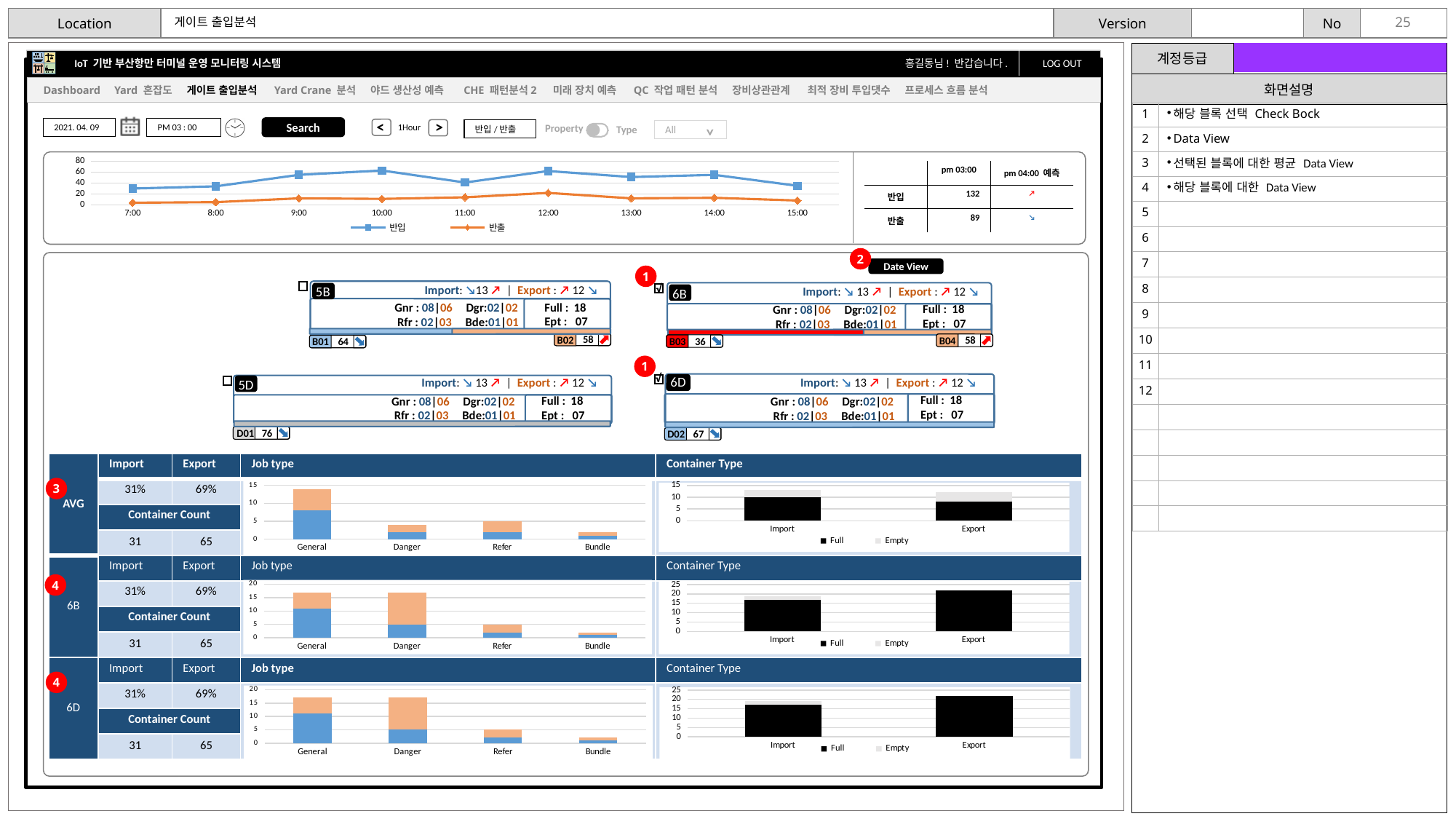
In the AVG Job type chart, is the total bar for General greater or less than 10? greater In the top line chart, which series has the larger value at 12:00, 반입 or 반출? 반입 How many series does the legend of the top line chart list? 2 In the AVG Job type chart, which category has the tallest bar? General In the top line chart, is the 반입 value at 10:00 greater or less than 40? greater In the 6D Job type chart, which category has the shortest bar? Bundle In the 6B Container Type chart, which bar is taller, Import or Export? Export What kind of chart is the top chart showing 반입 and 반출 from 7:00 to 15:00? line chart What kind of chart is the AVG Job type chart? bar chart In the top line chart, is the 반출 value at 7:00 greater or less than 20? less How many categories are shown on the x axis of the AVG Job type chart? 4 How many time points are plotted along the x axis of the top line chart? 9